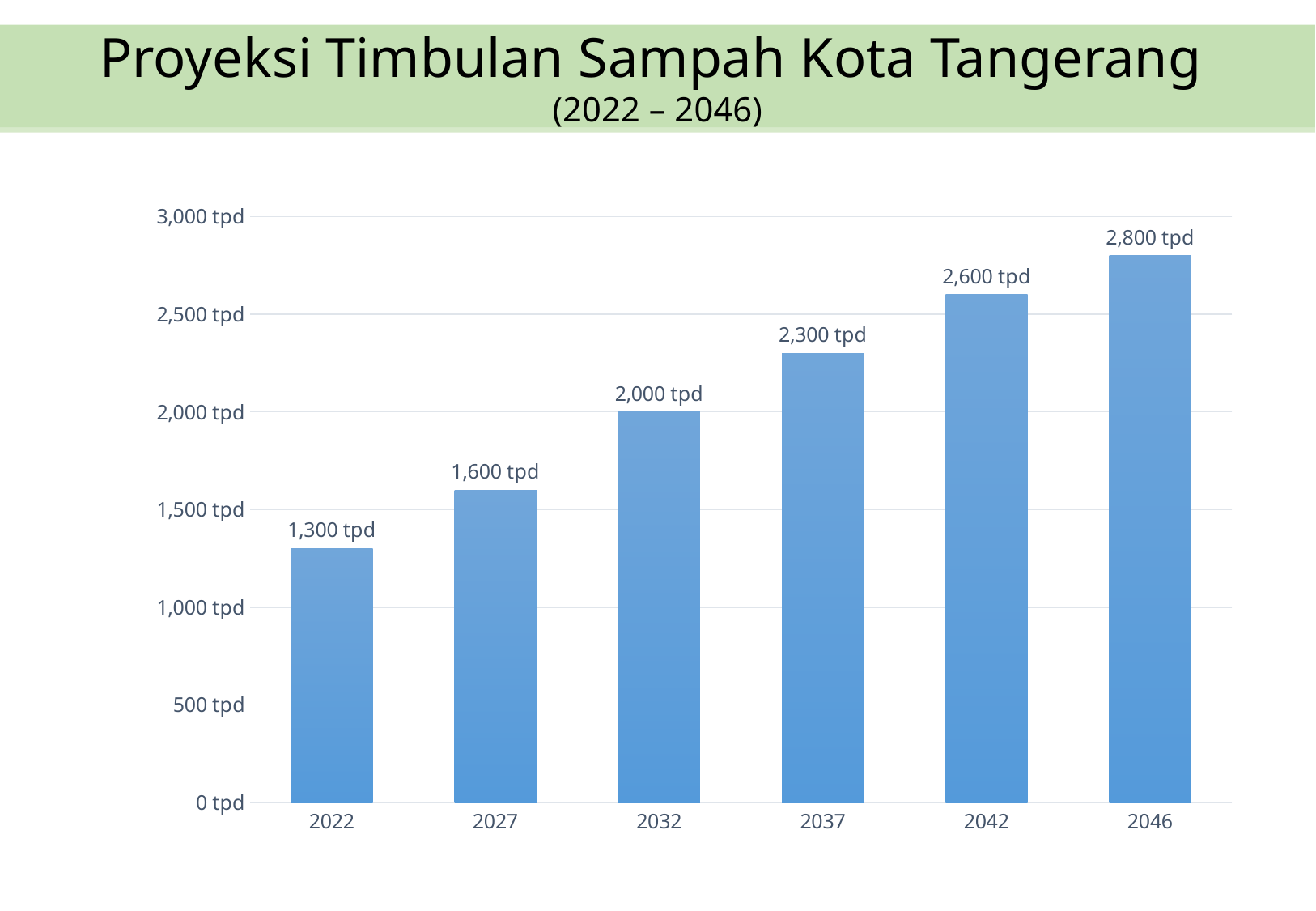
Which year has the highest projected waste generation? 2046 What kind of chart is shown on the slide? Bar chart What is the projected waste generation for 2037? 2,300 tpd Is the value for 2032 greater or less than 1,500 tpd? greater Which year has a larger projected value, 2027 or 2042? 2042 What is the projected waste generation for 2022? 1,300 tpd How many years are shown on the x axis? 6 Which year has the lowest projected waste generation? 2022 What is the difference between the projected values for 2032 and 2027? 400 tpd What is the difference between the projected values for 2046 and 2022? 1,500 tpd Do the projected values rise or fall from 2022 to 2046? Rise What is the projected waste generation for 2046? 2,800 tpd